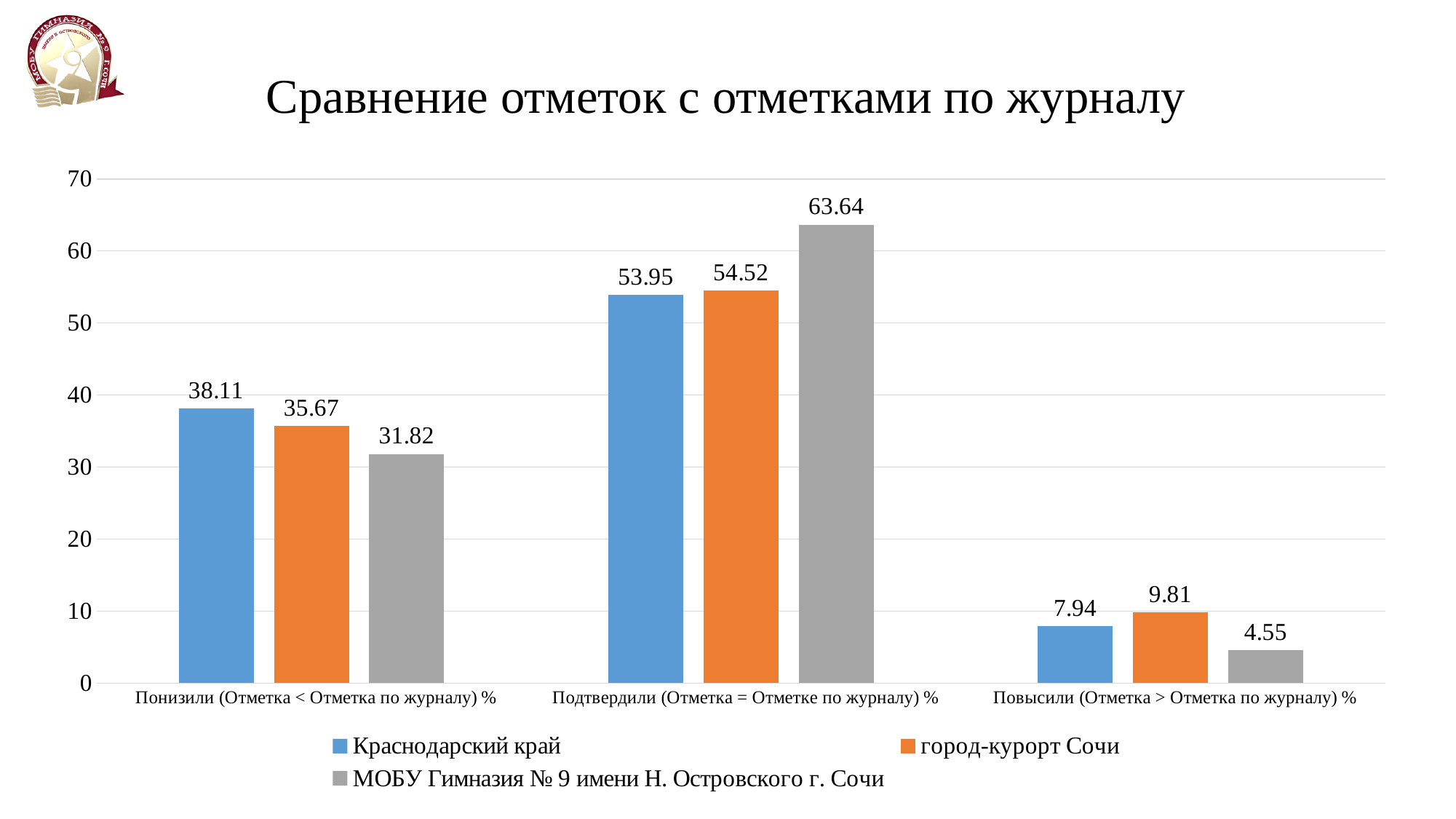
Which series has the highest value in the Подтвердили category? МОБУ Гимназия № 9 имени Н. Островского г. Сочи Is the value for город-курорт Сочи in the Подтвердили category greater or less than 50? greater Which series has the lowest value in the Повысили category? МОБУ Гимназия № 9 имени Н. Островского г. Сочи What is the difference between the Краснодарский край and МОБУ Гимназия № 9 values in the Понизили category? 6.29 What kind of chart is shown on the slide? bar chart What is the value for МОБУ Гимназия № 9 имени Н. Островского г. Сочи in the Подтвердили category? 63.64 What is the title of the chart? Сравнение отметок с отметками по журналу What is the value for город-курорт Сочи in the Повысили category? 9.81 How many categories are shown on the x axis? 3 What is the value for Краснодарский край in the Понизили category? 38.11 How many series does the legend list? 3 Which is larger in the Повысили category: Краснодарский край or город-курорт Сочи? город-курорт Сочи